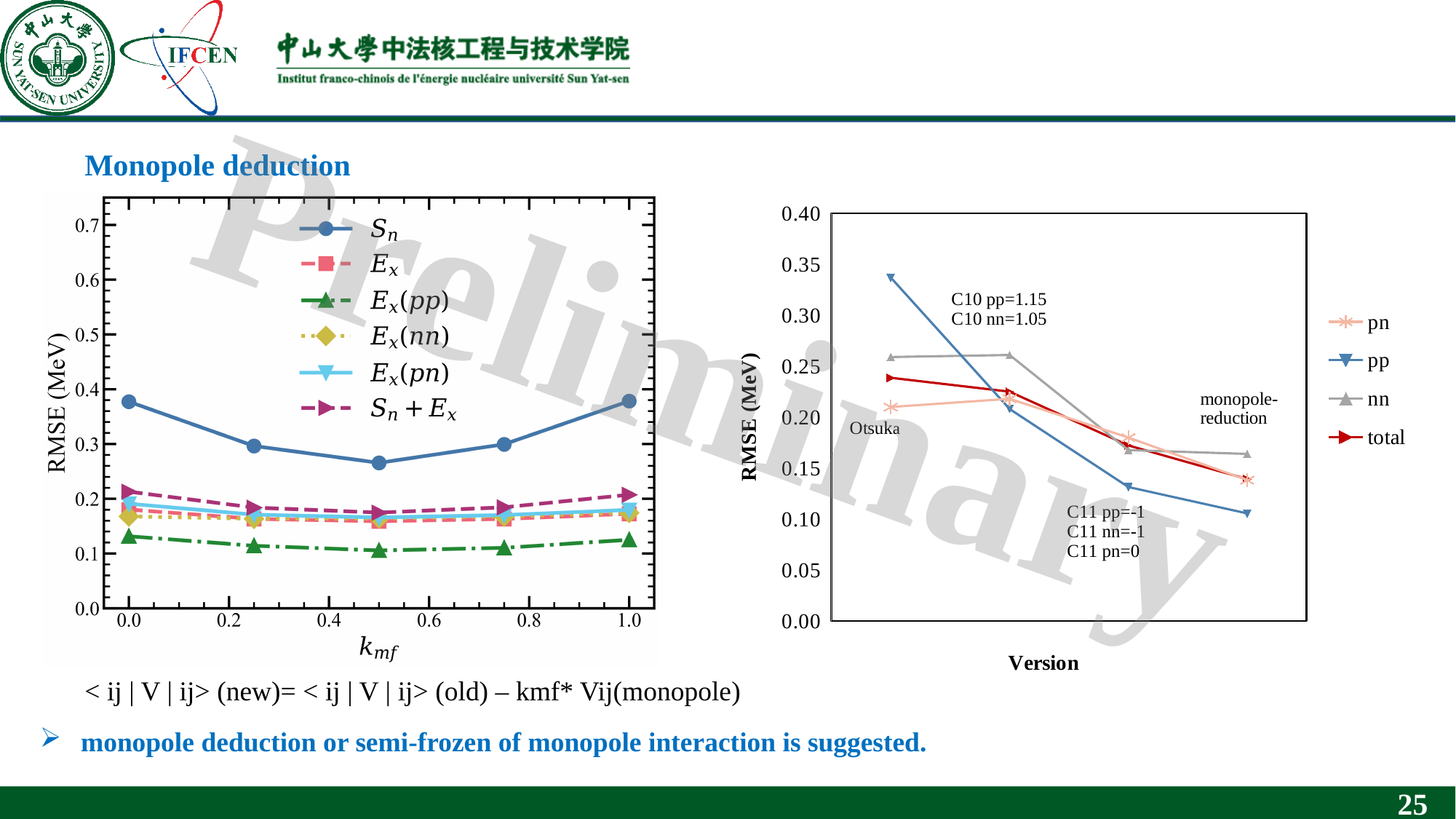
In the right chart (RMSE vs Version), which series has the highest RMSE at the Otsuka version? pp What kind of chart is the left chart (RMSE vs k_mf)? line chart In the left chart (RMSE vs k_mf), how many k_mf points are plotted for each series? 5 In the left chart (RMSE vs k_mf), is the RMSE of S_n at k_mf = 0.5 greater or less than 0.3? less In the right chart (RMSE vs Version), does the RMSE of pp rise or fall from the Otsuka version to the monopole-reduction version? fall In the left chart (RMSE vs k_mf), how does the RMSE of S_n change as k_mf goes from 0.0 to 1.0? falls then rises In the left chart (RMSE vs k_mf), which series has the lowest RMSE across all k_mf values? E_x(pp) How many series does the legend of the right chart (RMSE vs Version) list? 4 In the left chart (RMSE vs k_mf), is the RMSE of S_n at k_mf = 0.0 greater or less than 0.3? greater In the left chart (RMSE vs k_mf), which series has the highest RMSE across all k_mf values? S_n In the right chart (RMSE vs Version), is the RMSE of pp at the Otsuka version greater or less than 0.30? greater How many series does the legend of the left chart (RMSE vs k_mf) list? 6